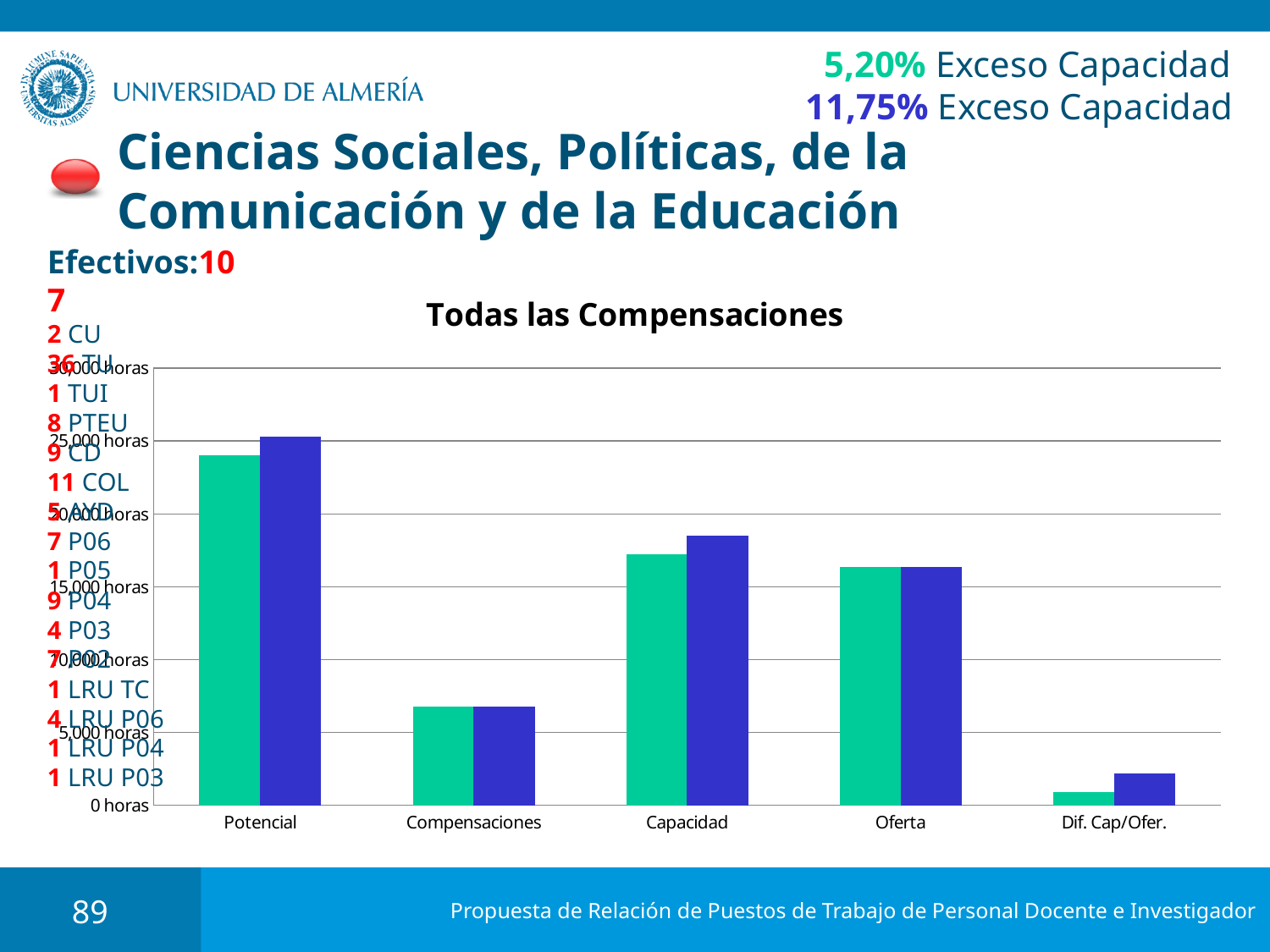
Is the teal bar for Compensaciones greater or less than 10,000 horas? less Which is larger, the teal bar for Capacidad or the teal bar for Compensaciones? Capacidad Is the blue bar for Dif. Cap/Ofer. greater or less than 5,000 horas? less What kind of chart is shown on the slide? bar chart Which category has the highest bars in the chart? Potencial How many categories are shown on the x axis of the chart? 5 Which is larger, the blue bar for Oferta or the blue bar for Potencial? Potencial Is the teal bar for Potencial greater or less than 20,000 horas? greater What is the title of the chart? Todas las Compensaciones Which category has the lowest bars in the chart? Dif. Cap/Ofer.